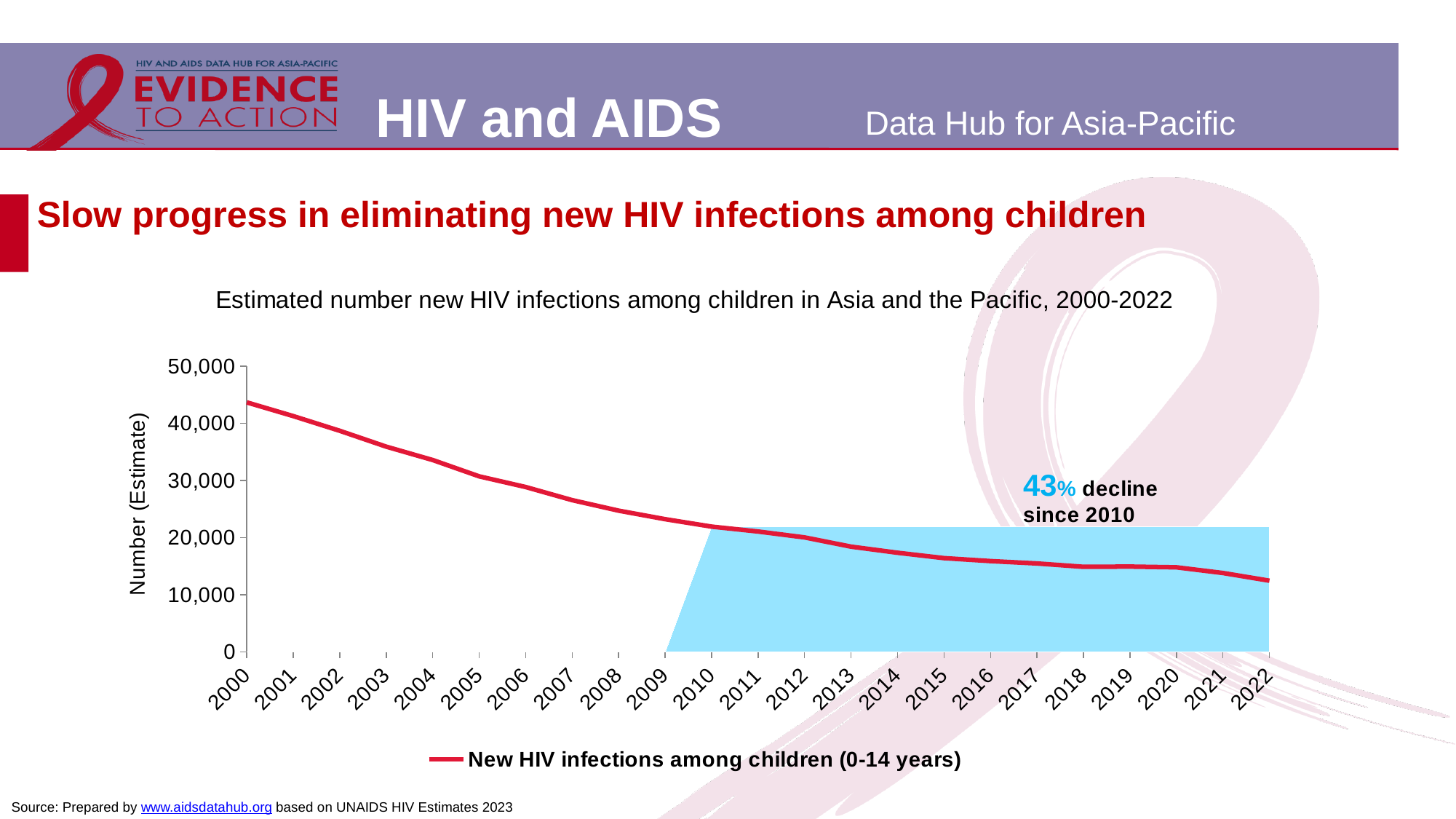
Is the value for 2005 greater or less than 20,000? greater Which year has the lowest value? 2022 Is the value for 2000 greater or less than 40,000? greater Do the values rise or fall from 2000 to 2022? fall Which year has the larger value, 2003 or 2015? 2003 How many series does the legend list? 1 How many years are plotted along the x axis? 23 What kind of chart is shown on the slide? line chart What is the title of the chart? Estimated number new HIV infections among children in Asia and the Pacific, 2000-2022 What is the legend entry for the plotted line? New HIV infections among children (0-14 years) Which year has the highest value? 2000 Is the value for 2022 greater or less than 20,000? less